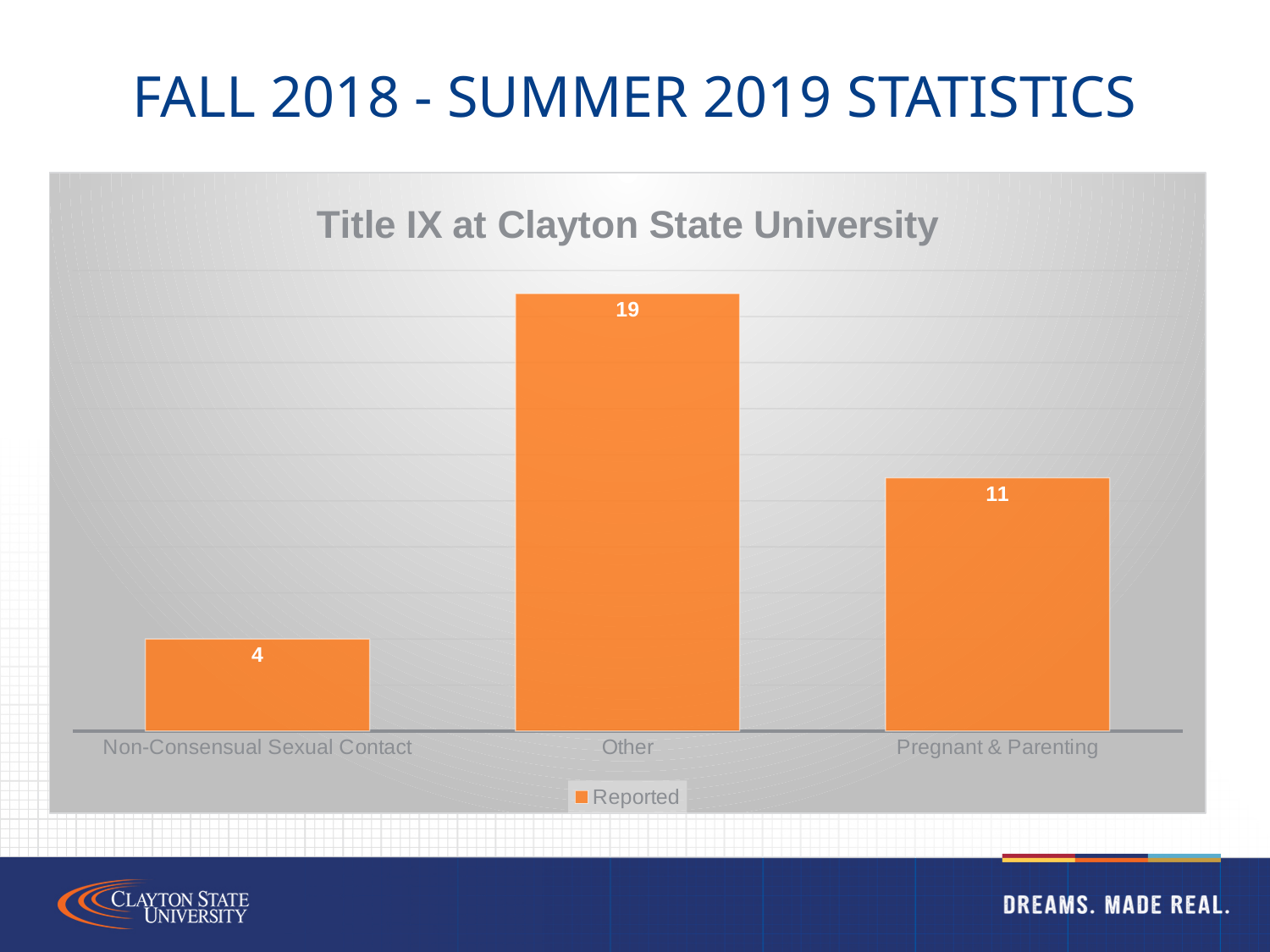
What is the difference between the reported values for Pregnant & Parenting and Non-Consensual Sexual Contact? 7 What kind of chart is shown on the slide? Bar chart What is the reported value for Other? 19 Which category has the lowest reported value? Non-Consensual Sexual Contact What is the reported value for Pregnant & Parenting? 11 What is the difference between the reported values for Other and Pregnant & Parenting? 8 How many categories are shown on the x axis? 3 How many series does the legend list? 1 What is the title of the chart? Title IX at Clayton State University What is the reported value for Non-Consensual Sexual Contact? 4 Which is larger, the reported value for Pregnant & Parenting or for Non-Consensual Sexual Contact? Pregnant & Parenting Which category has the highest reported value? Other